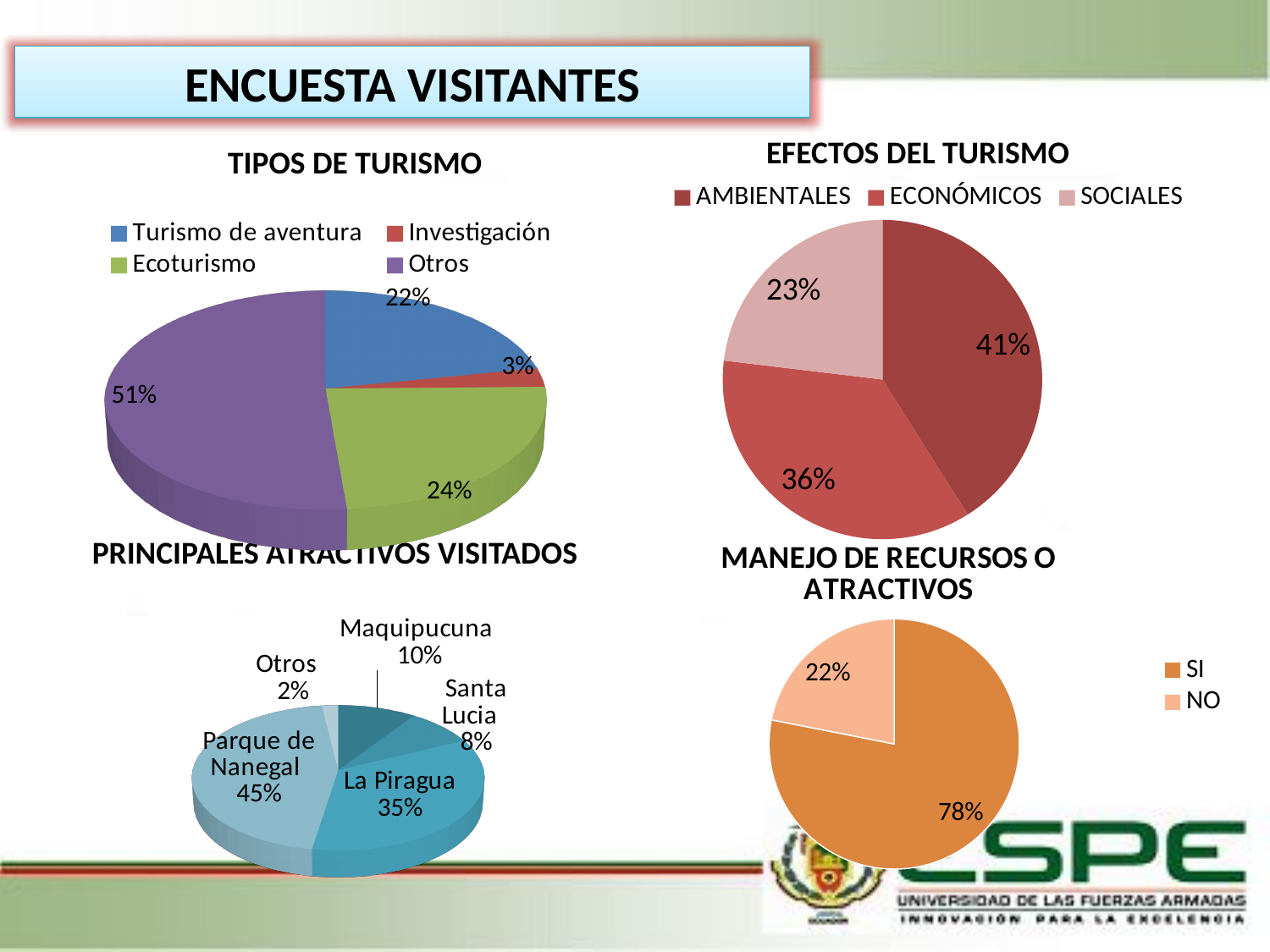
In the PRINCIPALES ATRACTIVOS VISITADOS chart, how many slices are there? 5 In the EFECTOS DEL TURISMO chart, how many categories does the legend list? 3 In the TIPOS DE TURISMO chart, what is the difference between Ecoturismo and Turismo de aventura? 2% In the PRINCIPALES ATRACTIVOS VISITADOS chart, what share is La Piragua? 35% What type of chart is the MANEJO DE RECURSOS O ATRACTIVOS chart? Pie chart In the EFECTOS DEL TURISMO chart, which category has the largest share? AMBIENTALES In the PRINCIPALES ATRACTIVOS VISITADOS chart, which attraction has the largest share? Parque de Nanegal In the TIPOS DE TURISMO chart, what share is Otros? 51% In the PRINCIPALES ATRACTIVOS VISITADOS chart, which is larger, Maquipucuna or Santa Lucia? Maquipucuna In the MANEJO DE RECURSOS O ATRACTIVOS chart, what share is SI? 78% In the EFECTOS DEL TURISMO chart, what share is ECONÓMICOS? 36% In the TIPOS DE TURISMO chart, which category has the smallest share? Investigación